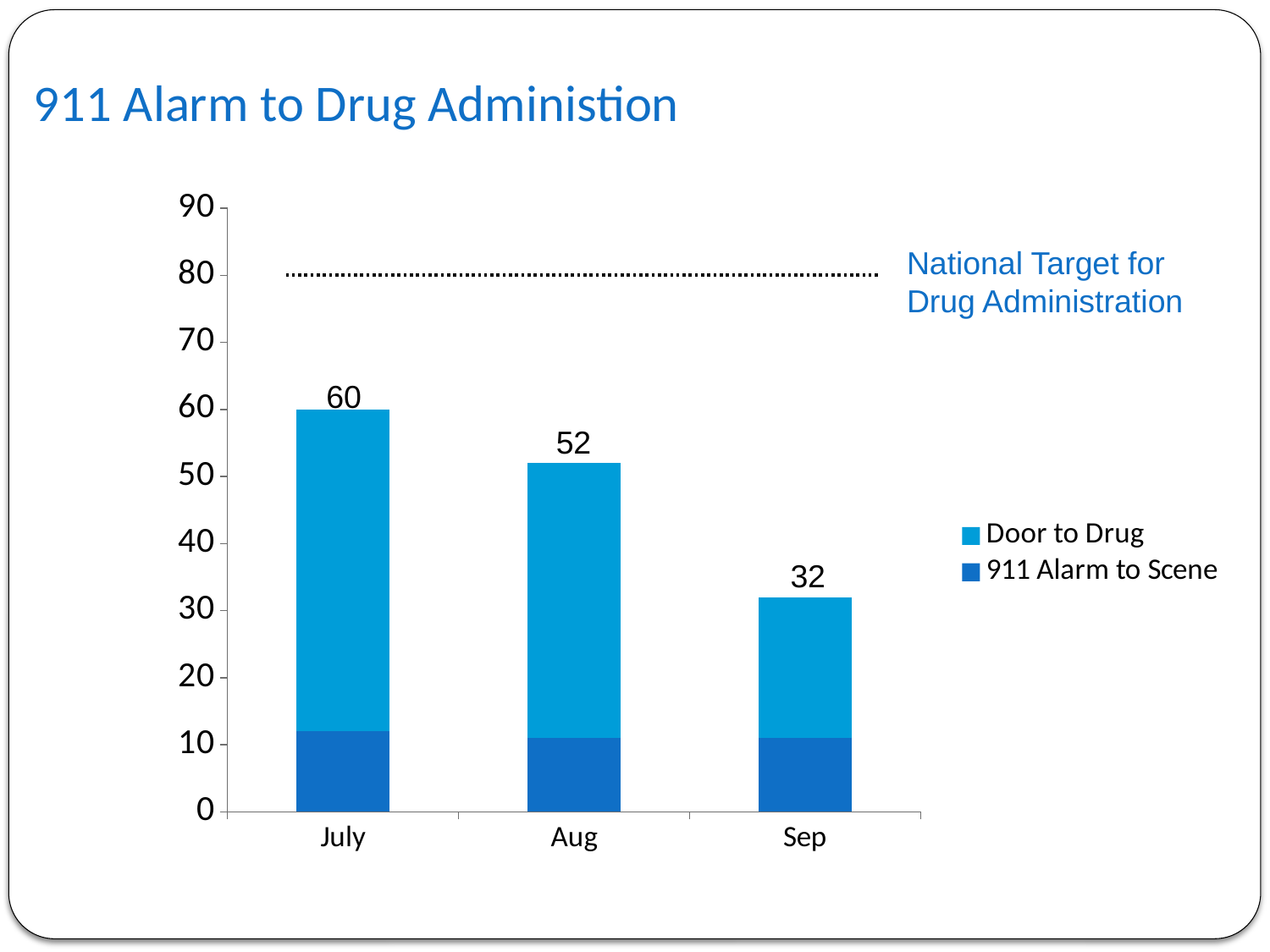
Is the 911 Alarm to Scene value for July greater or less than 20? less What is the total value of the stacked bar for July? 60 What is the total value of the stacked bar for Sep? 32 Do the total bar values rise or fall from July to Sep? Fall Which total is larger, Aug or Sep? Aug Which month has the lowest total bar? Sep How many series does the legend list? 2 What kind of chart is shown on the slide? Stacked bar chart How many months are shown on the x axis? 3 What is the total value of the stacked bar for Aug? 52 Which month has the highest total bar? July What is the difference between the total for July and the total for Sep? 28